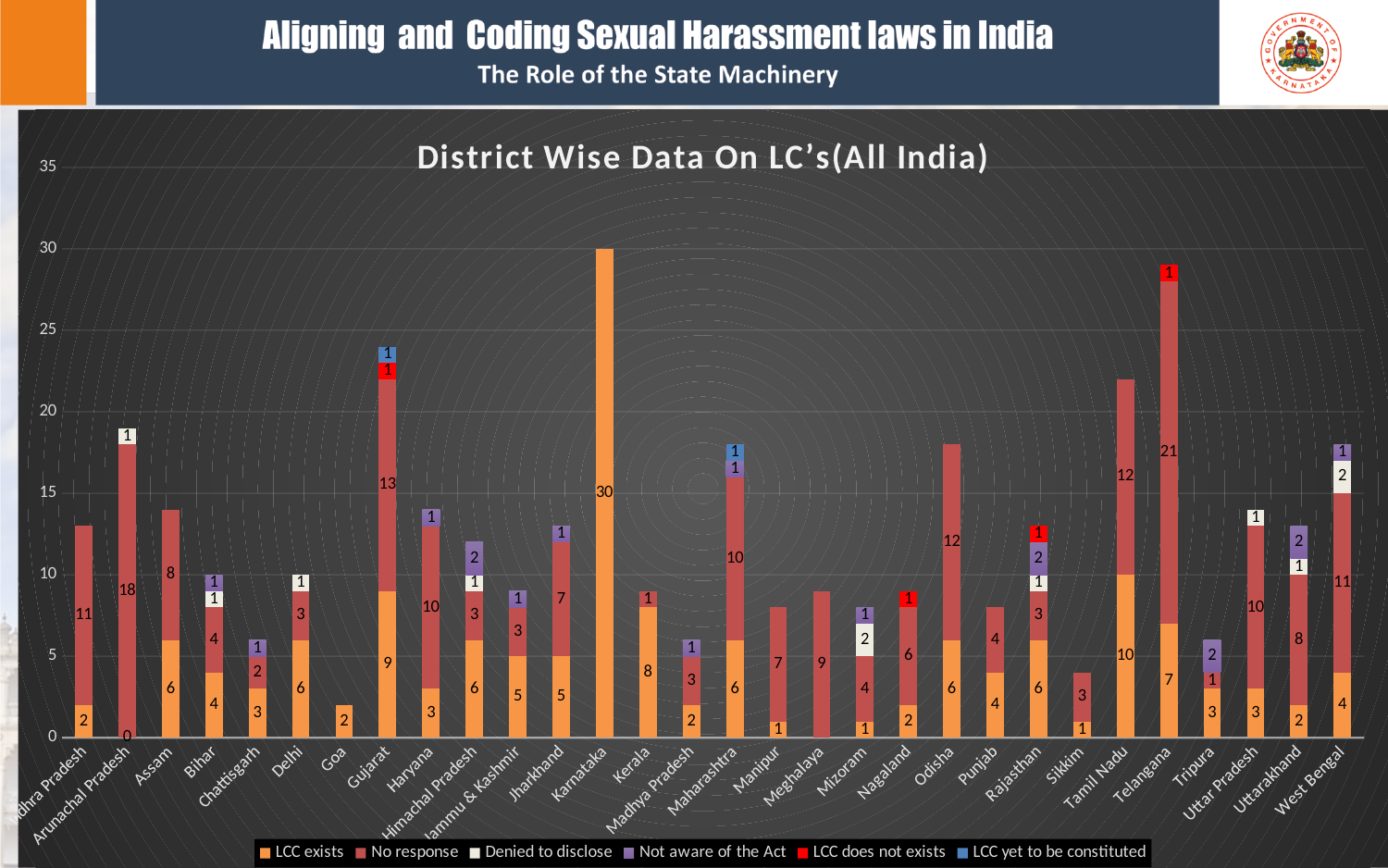
What is the 'No response' value for Arunachal Pradesh? 18 Which is larger, the 'LCC exists' value for Kerala or for Meghalaya's 'No response'? Meghalaya's 'No response' What is the difference between the 'No response' values for Odisha and Assam? 4 How many series does the legend list? 6 Which state has the tallest stacked bar? Karnataka What is the 'No response' value for Telangana? 21 What is the total of the stacked bar for Gujarat? 24 Which state has the shortest stacked bar? Goa What kind of chart is shown on the slide? Stacked bar chart What is the total of the stacked bar for West Bengal? 18 What is the title of the chart? District Wise Data On LC's(All India) What is the 'LCC exists' value for Tamil Nadu? 10